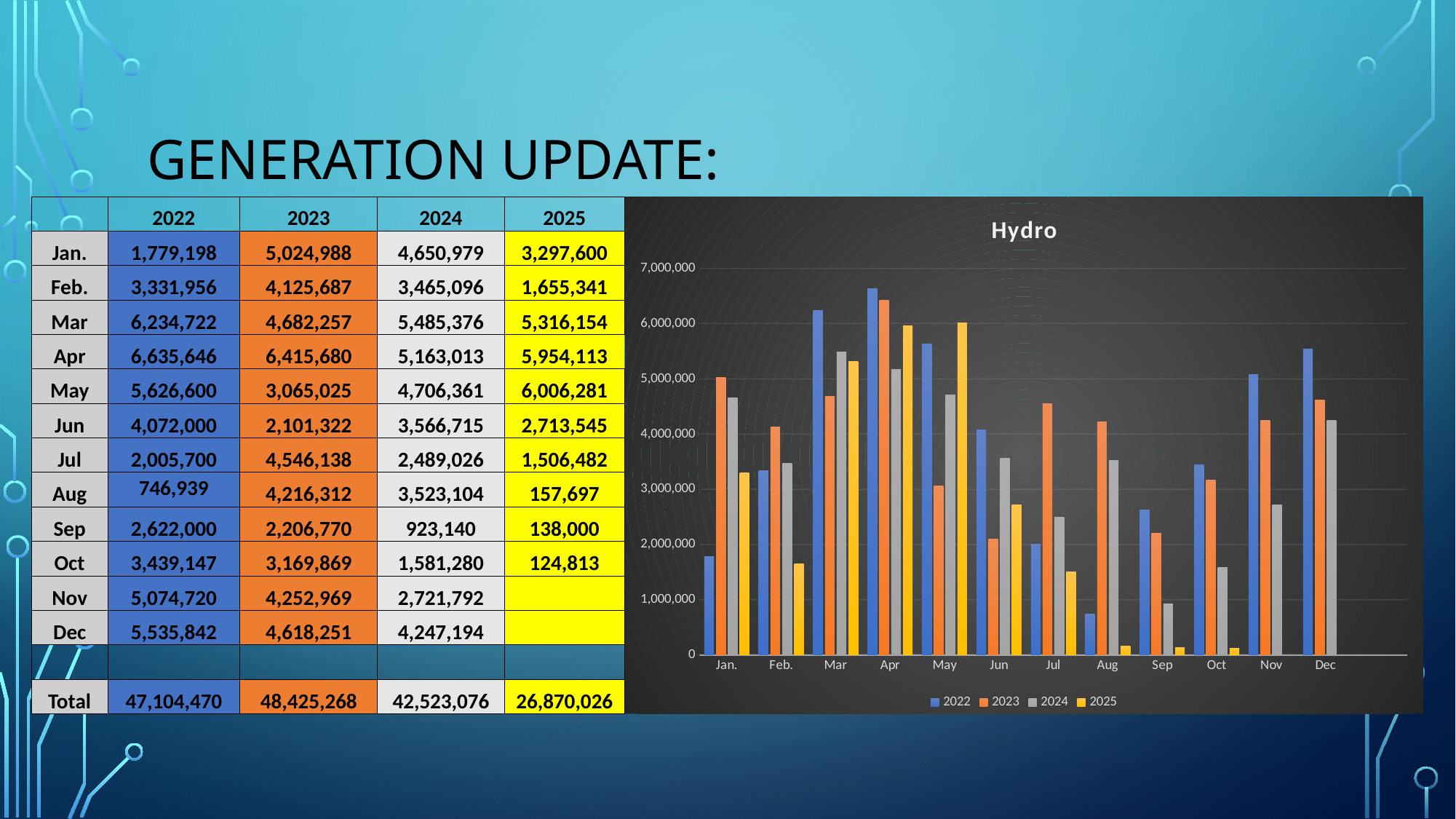
What is the difference between the August 2023 value and the August 2022 value? 3,469,373 Do the 2025 values rise or fall from June to October in the Hydro chart? fall What is the title of the chart on the slide? Hydro What is the total generation for 2024 shown in the table? 42,523,076 Which month has the highest 2022 value in the Hydro chart? Apr How many series does the legend of the Hydro chart list? 4 What kind of chart is the Hydro chart? bar chart What is the Hydro generation value for April 2022? 6,635,646 Which month has the lowest 2025 value in the Hydro chart? Oct How many months are shown on the x axis of the Hydro chart? 12 Is the 2023 value for July greater or less than 4,000,000? greater In the Hydro chart, which is larger for January: the 2022 value or the 2023 value? 2023